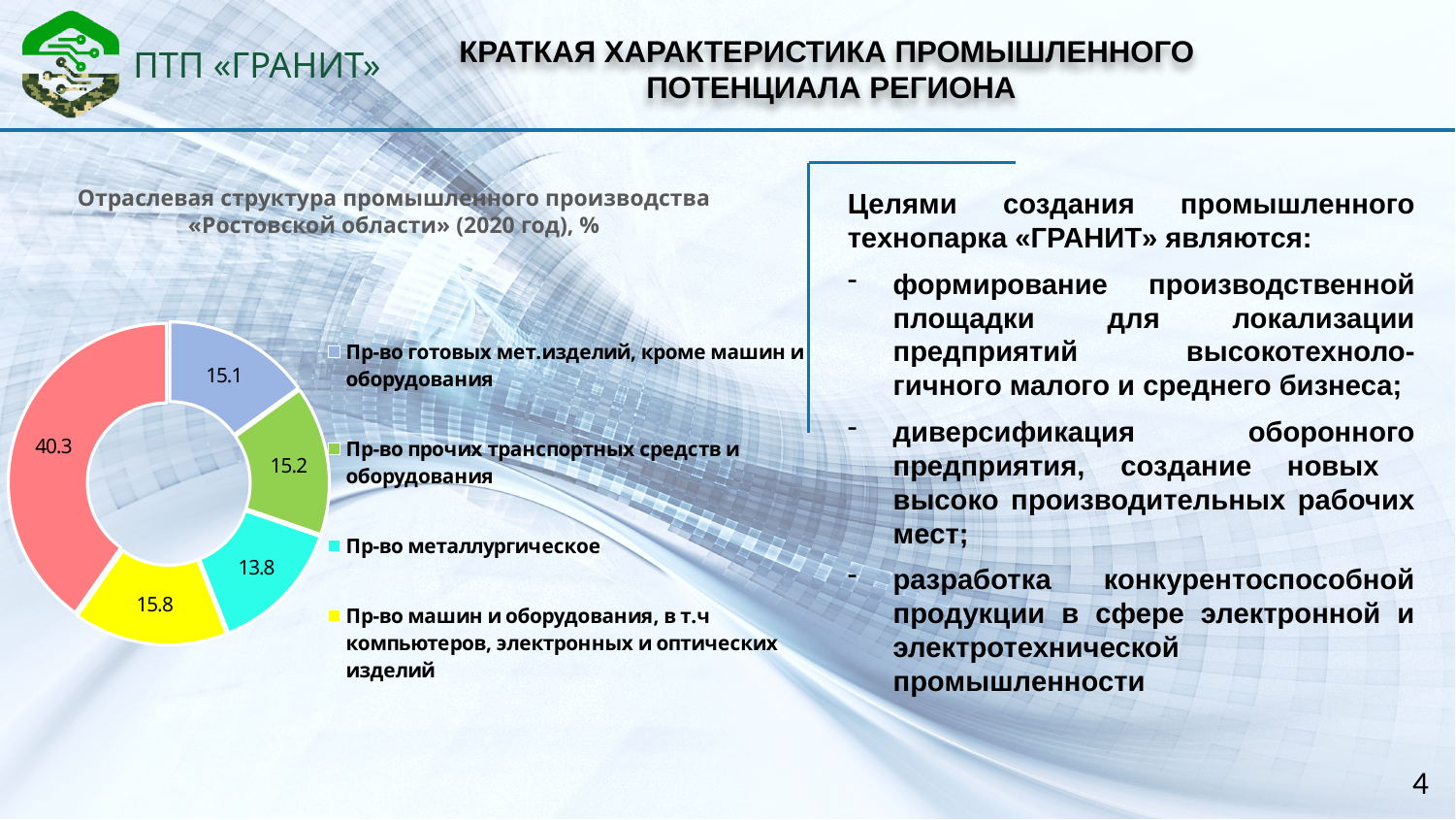
What value is shown for «Пр-во прочих транспортных средств и оборудования»? 15.2 What is the largest value labelled on the chart? 40.3 What value is shown for «Пр-во машин и оборудования, в т.ч компьютеров, электронных и оптических изделий»? 15.8 What is the chart's title? Отраслевая структура промышленного производства «Ростовской области» (2020 год), % Which category has the smallest value on the chart? Пр-во металлургическое How many entries does the legend list? 4 What kind of chart is shown on the slide? doughnut (pie) chart How many slices does the chart have? 5 Which is larger: the value for «Пр-во машин и оборудования» or for «Пр-во металлургическое»? Пр-во машин и оборудования What value is shown for «Пр-во готовых мет.изделий, кроме машин и оборудования»? 15.1 What value is shown for «Пр-во металлургическое»? 13.8 What is the difference between the values for «Пр-во машин и оборудования» and «Пр-во металлургическое»? 2.0